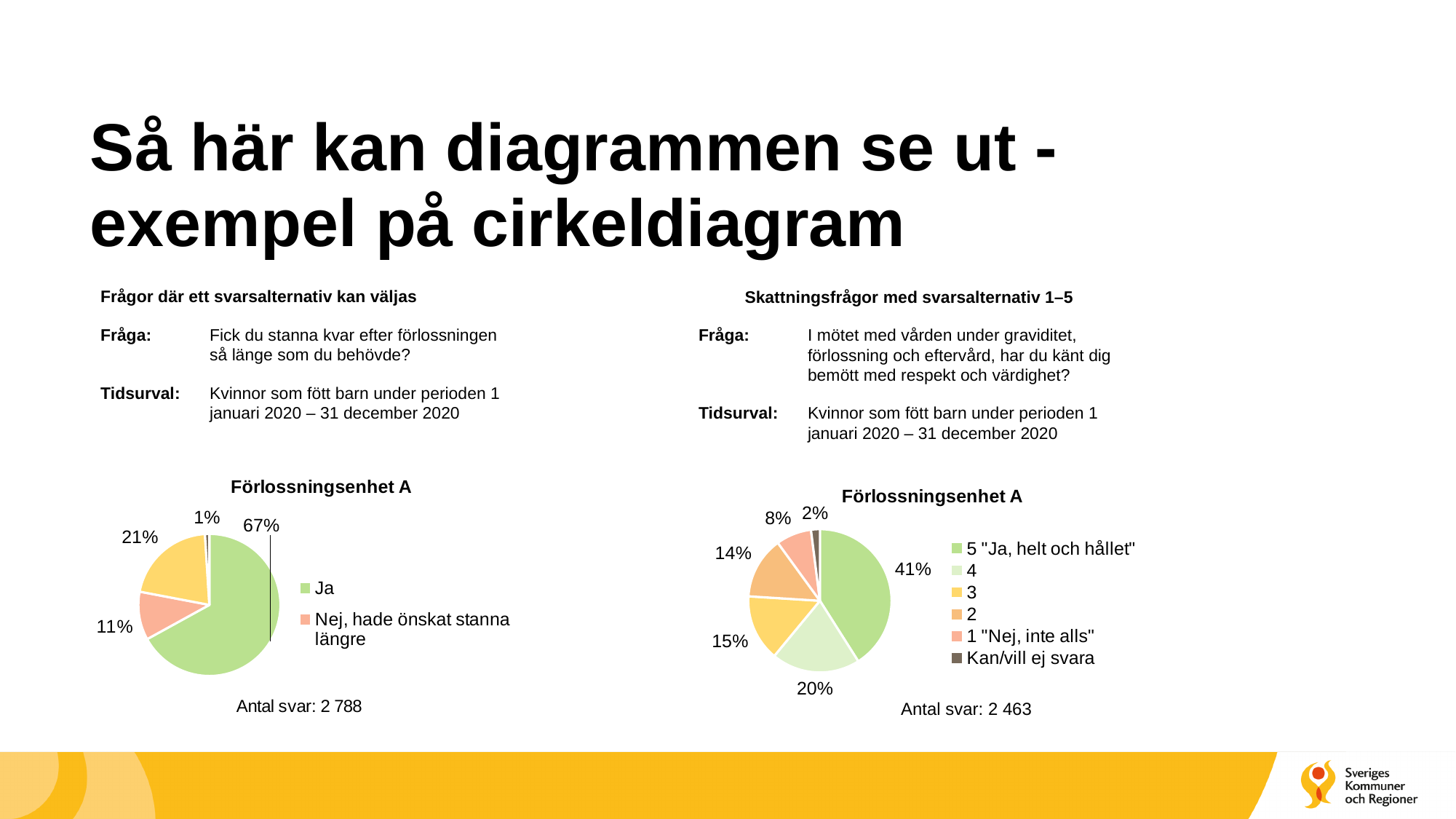
What is the number of responses (Antal svar) stated under the left pie chart? 2 788 In the left pie chart, how many percentage points larger is "Ja" than "Nej, hade önskat stanna längre"? 56 percentage points In the right pie chart, which category has the smallest slice? Kan/vill ej svara In the left pie chart, which legend category has the largest slice? Ja In the right pie chart, what percentage is shown for 5 "Ja, helt och hållet"? 41% In the right pie chart, how many percentage points larger is 5 "Ja, helt och hållet" than category 4? 21 percentage points What kind of chart is the left chart on the slide? Pie chart In the left pie chart, what percentage is shown for "Ja"? 67% In the right pie chart, what percentage is shown for "Kan/vill ej svara"? 2% How many entries does the legend of the right pie chart list? 6 In the left pie chart, what percentage is shown for "Nej, hade önskat stanna längre"? 11% In the right pie chart, what percentage is shown for category 4? 20%